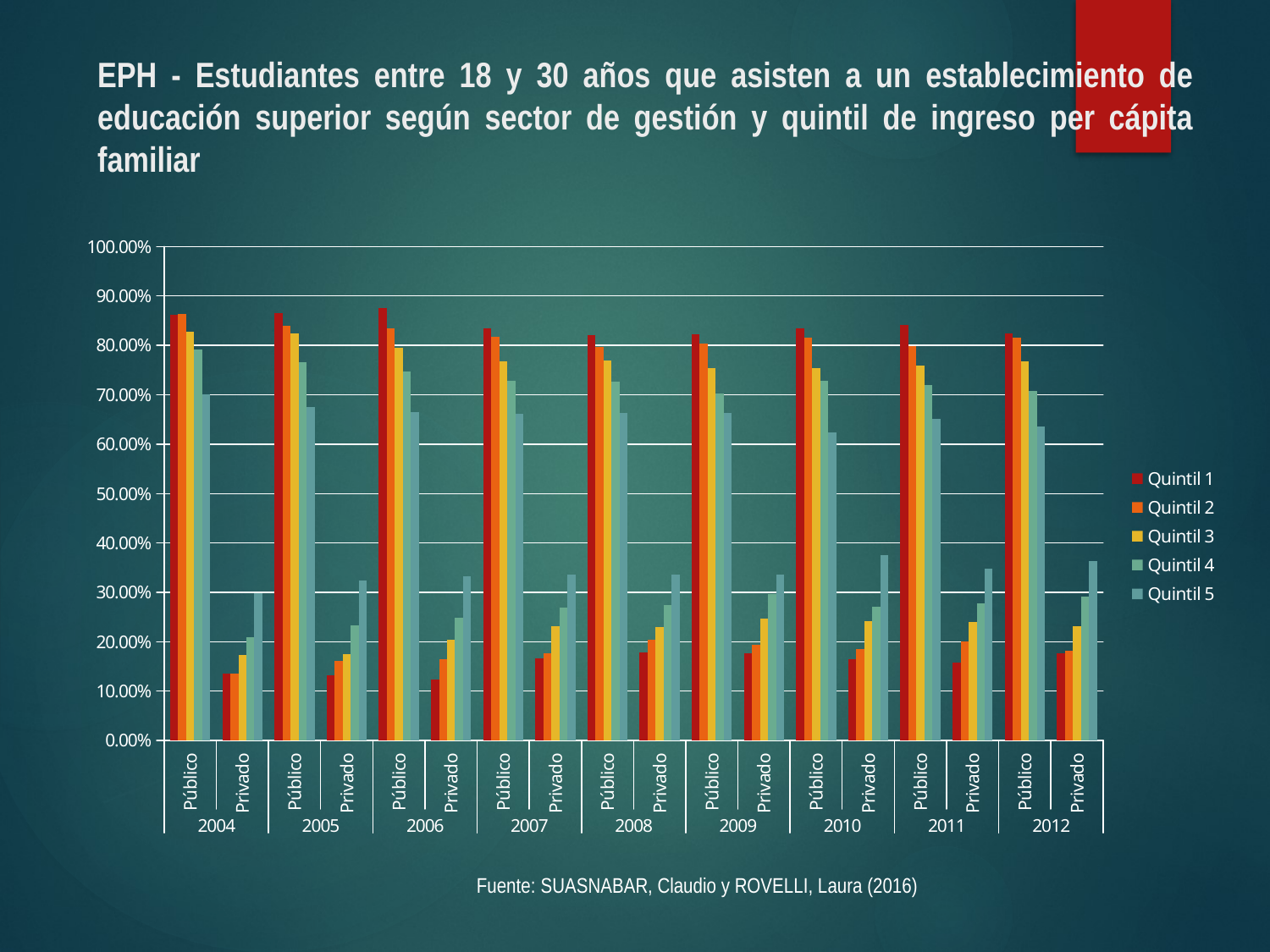
Is the value for Quintil 5 in Público 2004 greater or less than 60.00%? greater Within the Privado 2010 group, which quintil has the highest value? Quintil 5 How many years are shown along the x axis? 9 Within the Público 2004 group, which quintil has the lowest value? Quintil 5 Is the value for Quintil 5 in Privado 2010 greater or less than 30.00%? greater Is the value for Quintil 1 in Privado 2004 greater or less than 20.00%? less Which is larger in 2004: Quintil 1 for Público or Quintil 1 for Privado? Público What is the source cited below the chart? SUASNABAR, Claudio y ROVELLI, Laura (2016) How many series does the legend list? 5 How many Público/Privado category groups are shown along the x axis in total? 18 What kind of chart is shown on the slide? bar chart